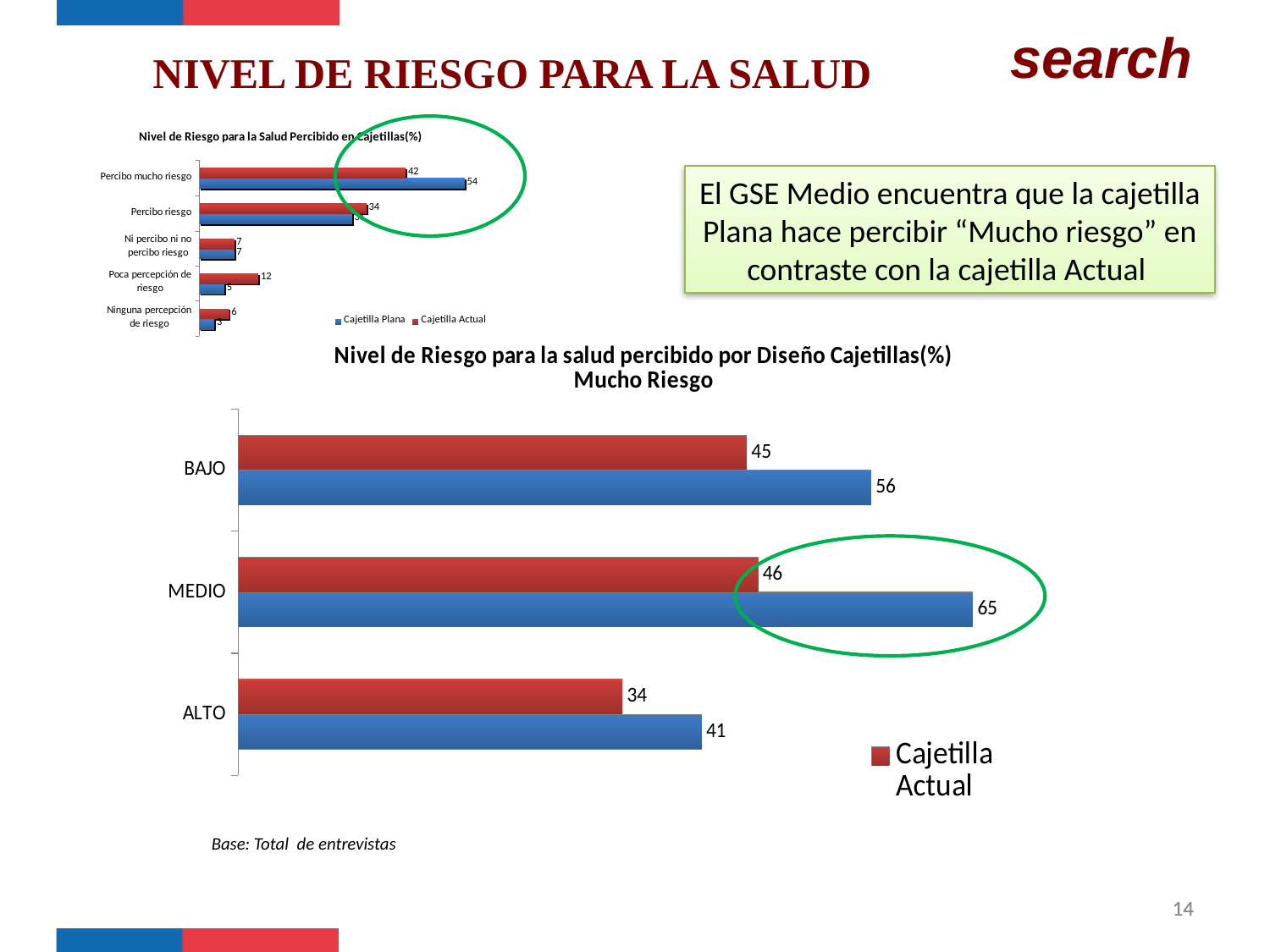
In the small chart at the top left, what is the Cajetilla Actual value for 'Poca percepción de riesgo'? 12 In the large chart 'Nivel de Riesgo para la salud percibido por Diseño Cajetillas(%) Mucho Riesgo', what is the value of the blue bar for MEDIO? 65 In the large chart 'Mucho Riesgo', what is the value of the Cajetilla Actual (red) bar for BAJO? 45 In the large chart 'Mucho Riesgo', what is the value of the Cajetilla Actual (red) bar for ALTO? 34 How many series does the legend of the small chart at the top left list? 2 What type of chart is the large chart 'Mucho Riesgo'? Bar chart In the large chart 'Mucho Riesgo', which category has the lowest Cajetilla Actual (red) value? ALTO In the large chart 'Mucho Riesgo', what is the difference between the blue bar and the red bar for MEDIO? 19 In the large chart 'Mucho Riesgo', which category has the highest blue bar value? MEDIO In the large chart 'Mucho Riesgo', which is larger for BAJO: the blue bar or the Cajetilla Actual (red) bar? The blue bar In the small chart at the top left, 'Nivel de Riesgo para la Salud Percibido en Cajetillas(%)', what is the Cajetilla Plana value for 'Percibo mucho riesgo'? 54 How many categories are shown in the large chart 'Mucho Riesgo'? 3